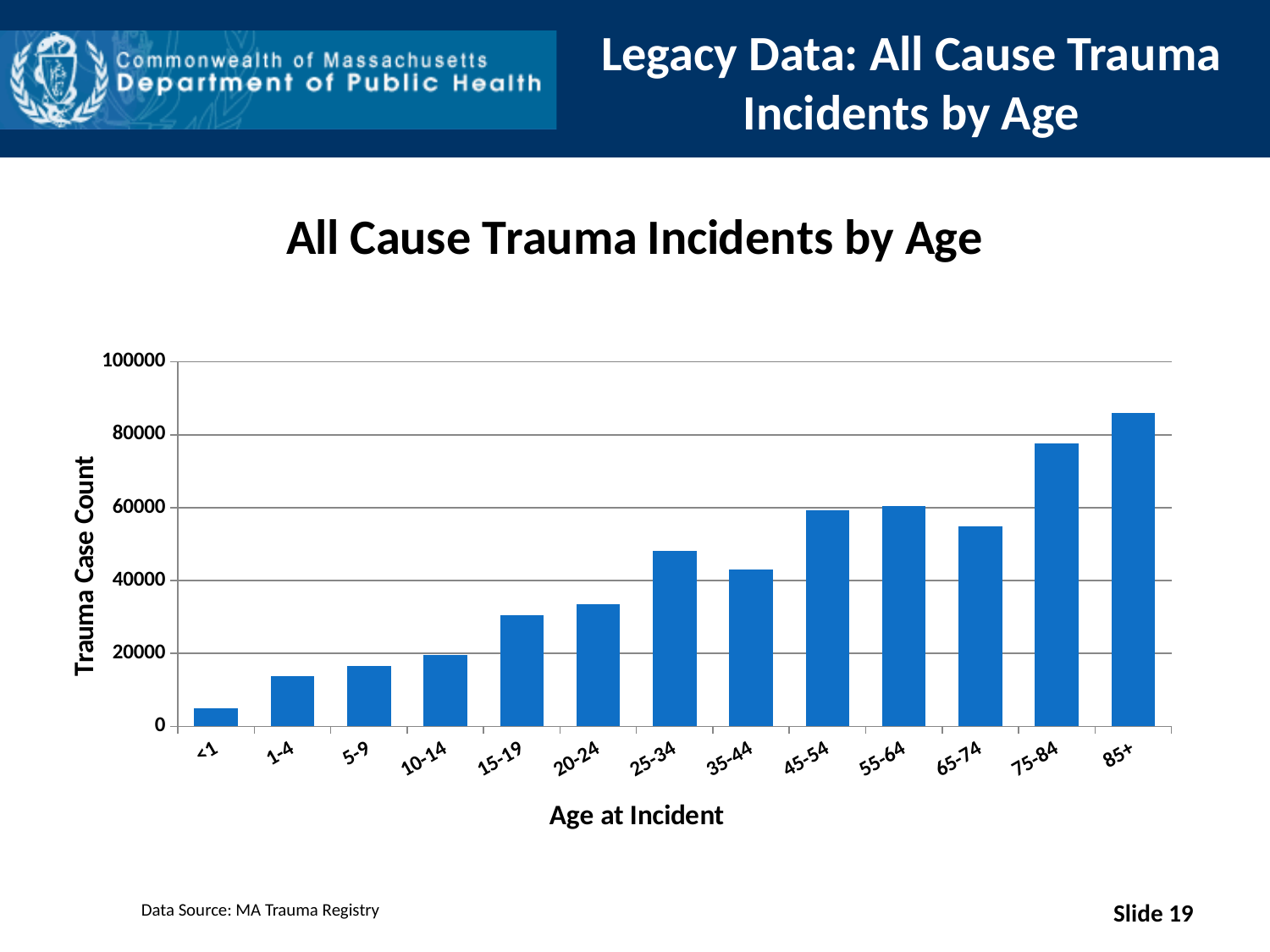
Is the trauma case count for the 15-19 age group greater or less than 20000? greater Which age group has a higher trauma case count, 25-34 or 35-44? 25-34 Which age group has a higher trauma case count, 65-74 or 75-84? 75-84 How many age categories are shown on the x axis? 13 Is the trauma case count for the 85+ age group greater or less than 80000? greater Which age group has the lowest trauma case count? <1 Is the trauma case count for the <1 age group greater or less than 20000? less Overall, do trauma case counts rise or fall as age at incident increases along the x axis? rise What is the title of the chart? All Cause Trauma Incidents by Age Which age group has the highest trauma case count? 85+ What kind of chart is shown on the slide? bar chart